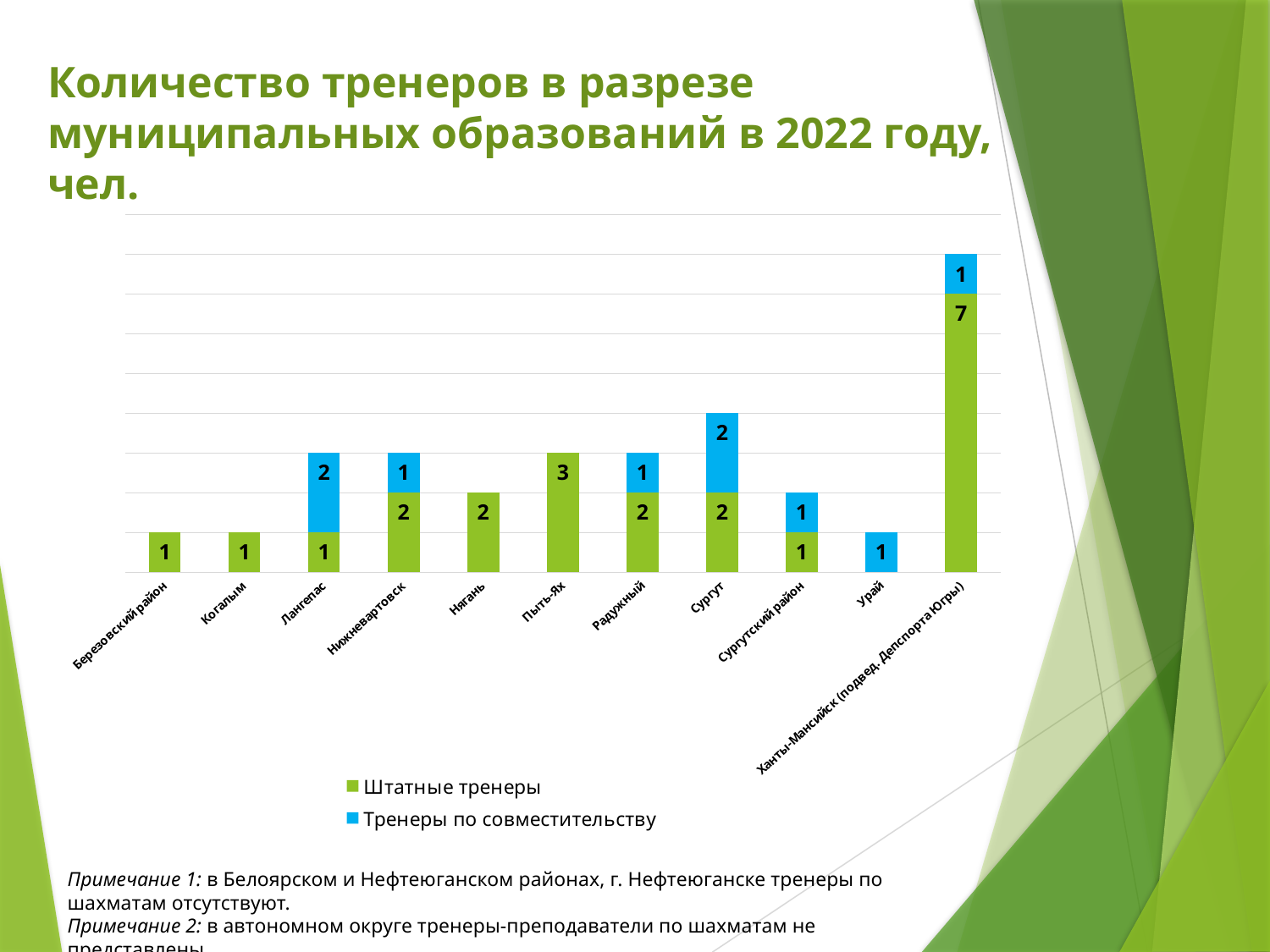
What is the value of Штатные тренеры for Пыть-Ях? 3 Which series is shown in blue in the legend? Тренеры по совместительству What is the difference between Штатные тренеры for Ханты-Мансийск (подвед. Депспорта Югры) and Штатные тренеры for Пыть-Ях? 4 What kind of chart is shown on the slide? stacked bar chart What is the total number of trainers for Сургут? 4 How many municipalities (categories) are shown on the x axis? 11 How many series does the legend list? 2 What is the total number of trainers for Ханты-Мансийск (подвед. Депспорта Югры)? 8 Which is larger: Тренеры по совместительству for Сургут or Тренеры по совместительству for Нижневартовск? Сургут What is the value of Тренеры по совместительству for Лангепас? 2 What is the value of Штатные тренеры for Ханты-Мансийск (подвед. Депспорта Югры)? 7 Which municipality has the highest total number of trainers? Ханты-Мансийск (подвед. Депспорта Югры)